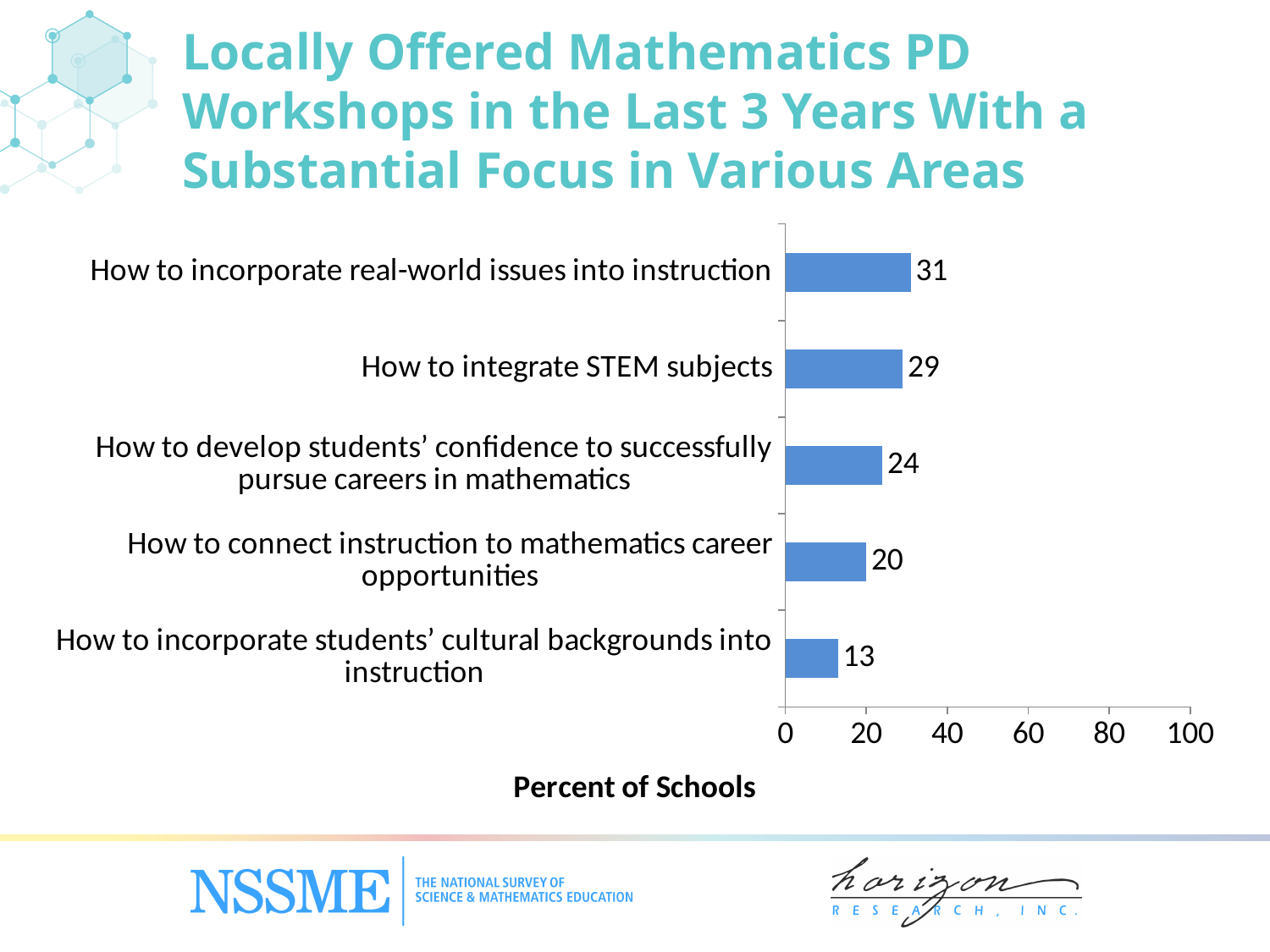
What is the difference between the values for 'How to incorporate real-world issues into instruction' and 'How to incorporate students' cultural backgrounds into instruction'? 18 How many areas are shown in the chart? 5 What kind of chart is shown on the slide? bar chart What percent of schools is shown for 'How to incorporate students' cultural backgrounds into instruction'? 13 What is the value for 'How to integrate STEM subjects'? 29 What percent of schools offered locally offered mathematics PD workshops with a substantial focus on how to incorporate real-world issues into instruction? 31 What is the value for 'How to connect instruction to mathematics career opportunities'? 20 Which area has the highest percent of schools? How to incorporate real-world issues into instruction What is the label of the horizontal axis? Percent of Schools Which is larger: the value for 'How to develop students' confidence to successfully pursue careers in mathematics' or the value for 'How to connect instruction to mathematics career opportunities'? How to develop students' confidence to successfully pursue careers in mathematics Which area has the lowest percent of schools? How to incorporate students' cultural backgrounds into instruction Is the value for 'How to integrate STEM subjects' greater or less than 40? less